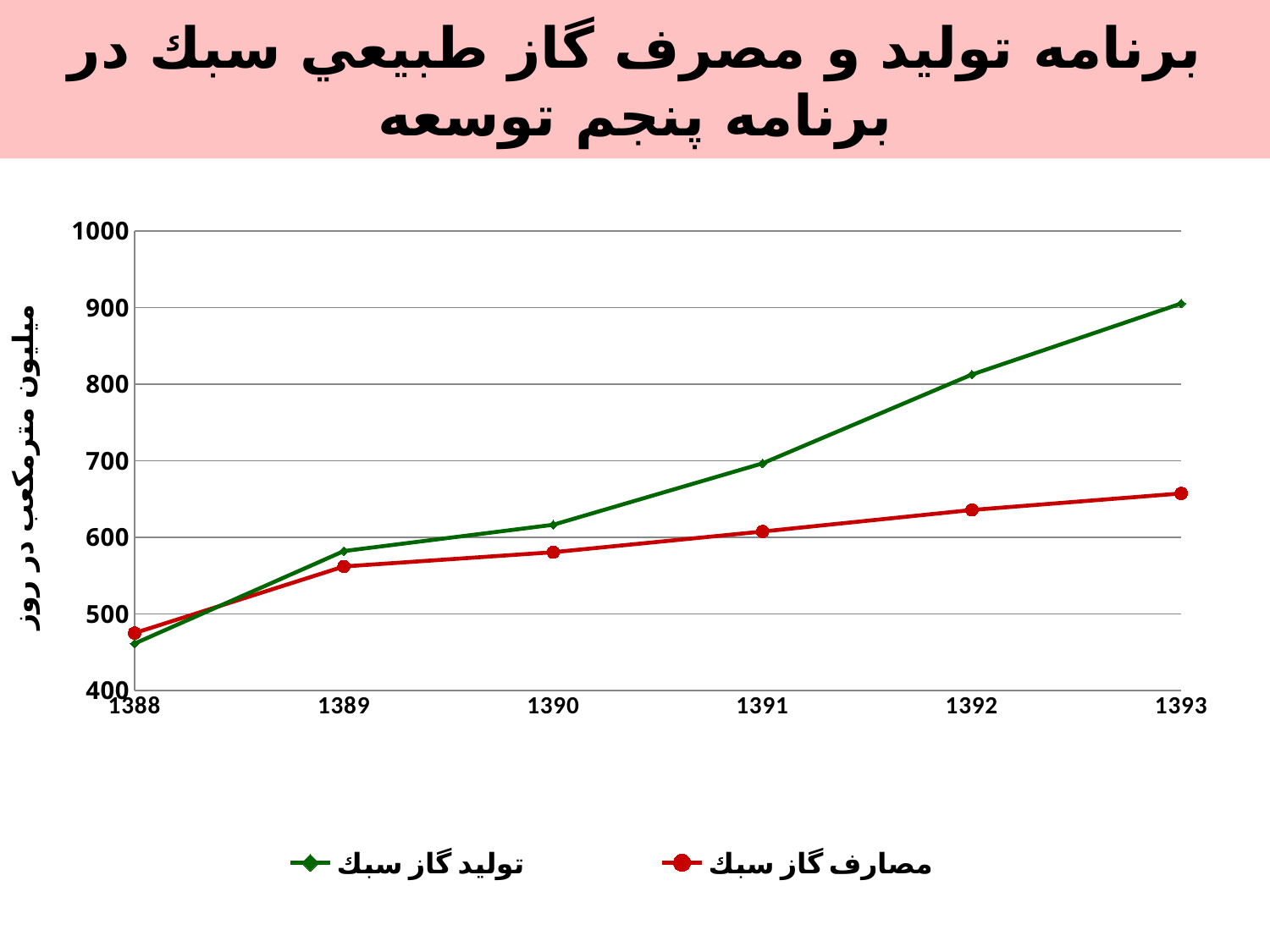
Is the value for مصارف گاز سبك in 1388 greater or less than 500? less In which year does توليد گاز سبك reach its highest value? 1393 How many years are plotted along the x axis? 6 Do the values for توليد گاز سبك rise or fall from 1388 to 1393? rise In which year is مصارف گاز سبك at its lowest value? 1388 Is the value for مصارف گاز سبك in 1390 greater or less than 600? less Is the value for مصارف گاز سبك in 1393 greater or less than 700? less What kind of chart is shown on the slide? line chart In 1393, which series has the larger value, توليد گاز سبك or مصارف گاز سبك? توليد گاز سبك How many series does the legend list? 2